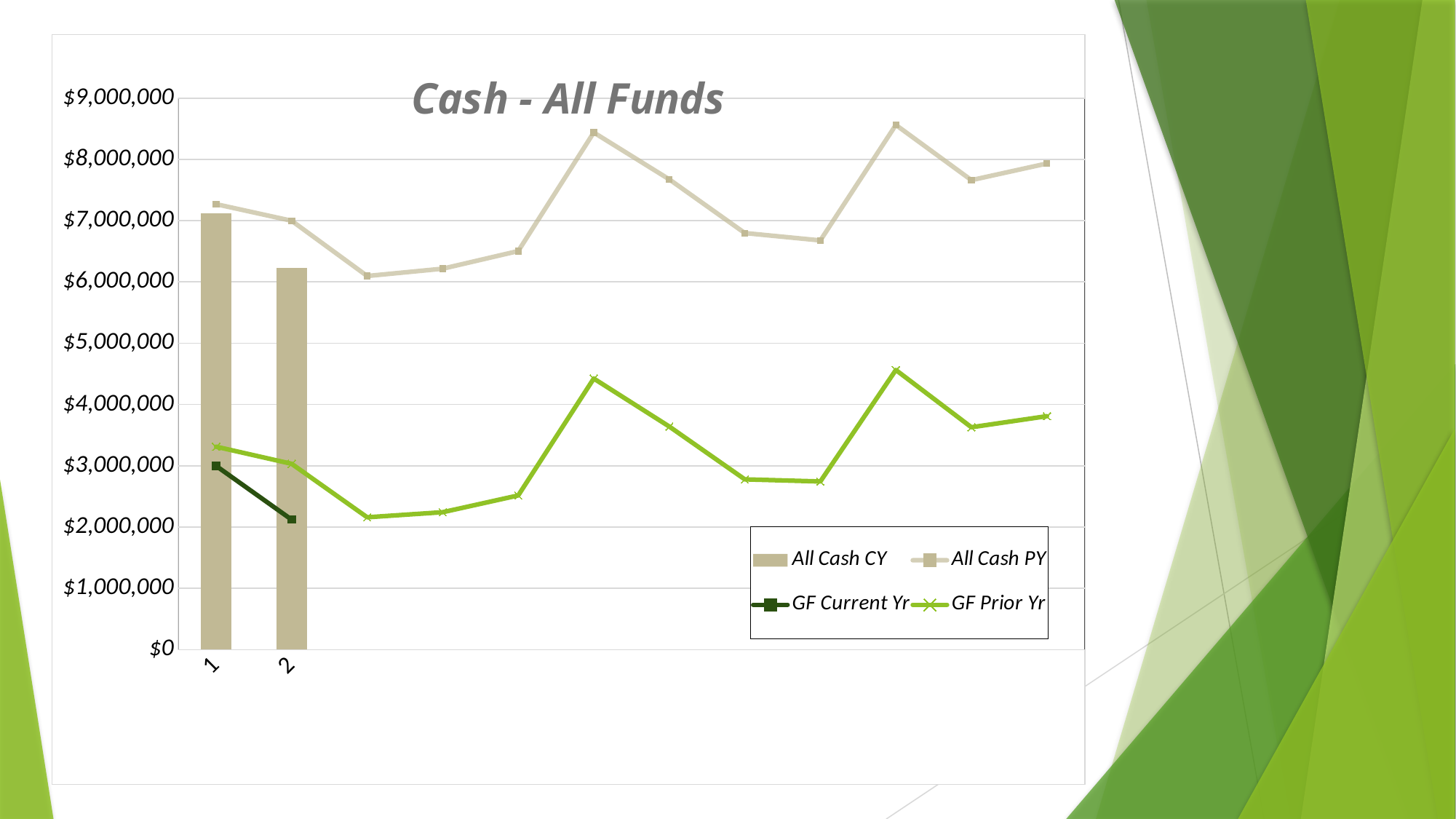
Is the GF Prior Yr value at category 1 greater or less than $3,000,000? greater Which legend entry is shown with a dark green line and square markers? GF Current Yr What kind of chart is this? Combination bar and line chart Is the All Cash CY value for category 2 greater or less than $7,000,000? less How many series does the legend list? 4 Which category has the taller All Cash CY bar, 1 or 2? 1 What is the title of the chart? Cash - All Funds At category 2, which is larger: GF Prior Yr or GF Current Yr? GF Prior Yr Does the GF Current Yr line rise or fall from category 1 to category 2? fall How many bars are plotted for the All Cash CY series? 2 Is the All Cash PY value at category 1 greater or less than $7,000,000? greater